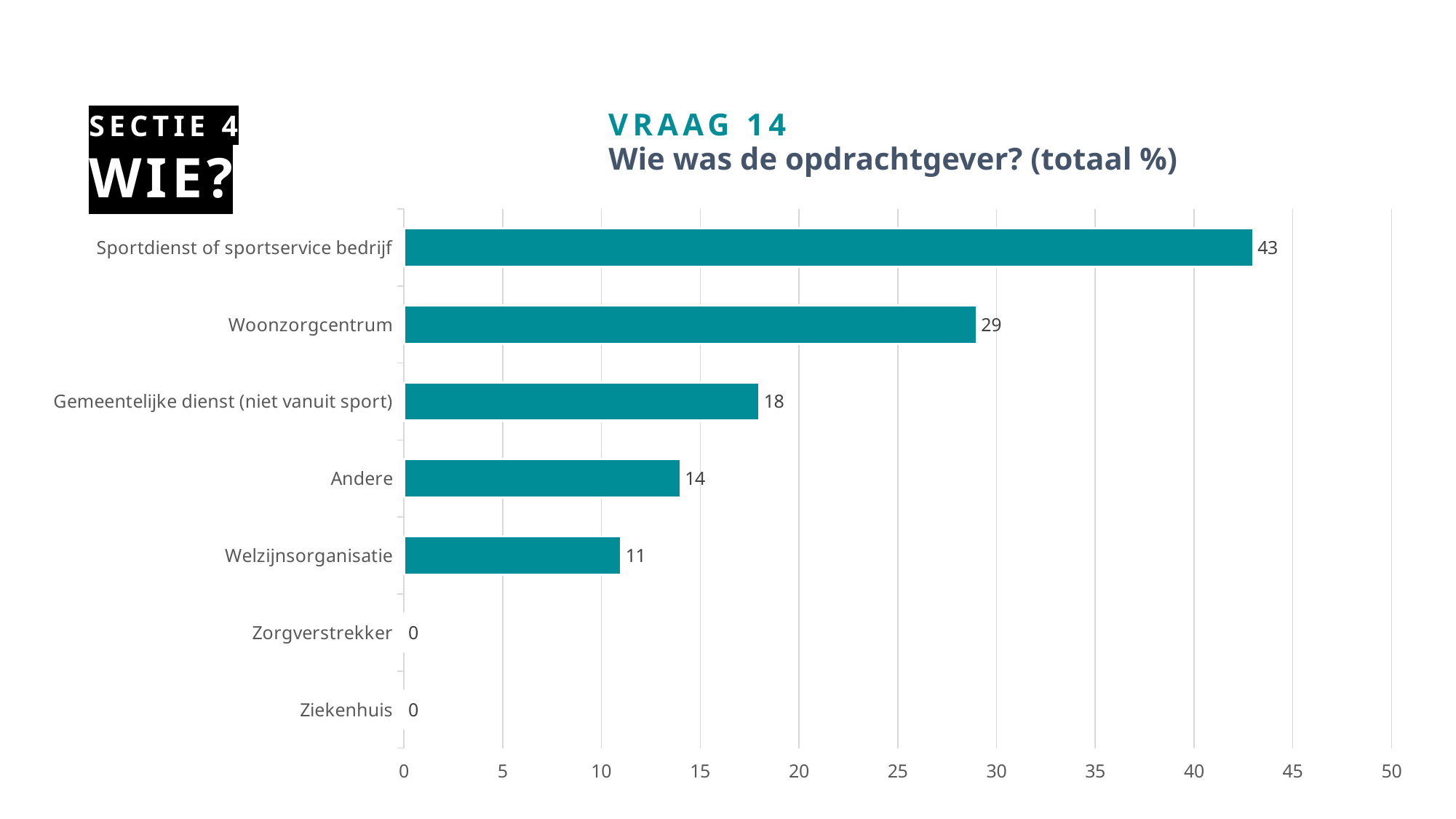
Which category has the highest value? Sportdienst of sportservice bedrijf What is the value for Zorgverstrekker? 0 What kind of chart is shown on the slide? bar chart What is the difference between the values for Sportdienst of sportservice bedrijf and Woonzorgcentrum? 14 How many categories are shown in the chart? 7 What is the value for Welzijnsorganisatie? 11 What is the title of the chart? Wie was de opdrachtgever? (totaal %) What is the value for Gemeentelijke dienst (niet vanuit sport)? 18 Which is larger, the value for Andere or the value for Welzijnsorganisatie? Andere What is the value for Woonzorgcentrum? 29 Is the value for Woonzorgcentrum greater or less than 25? greater What is the value for Sportdienst of sportservice bedrijf? 43